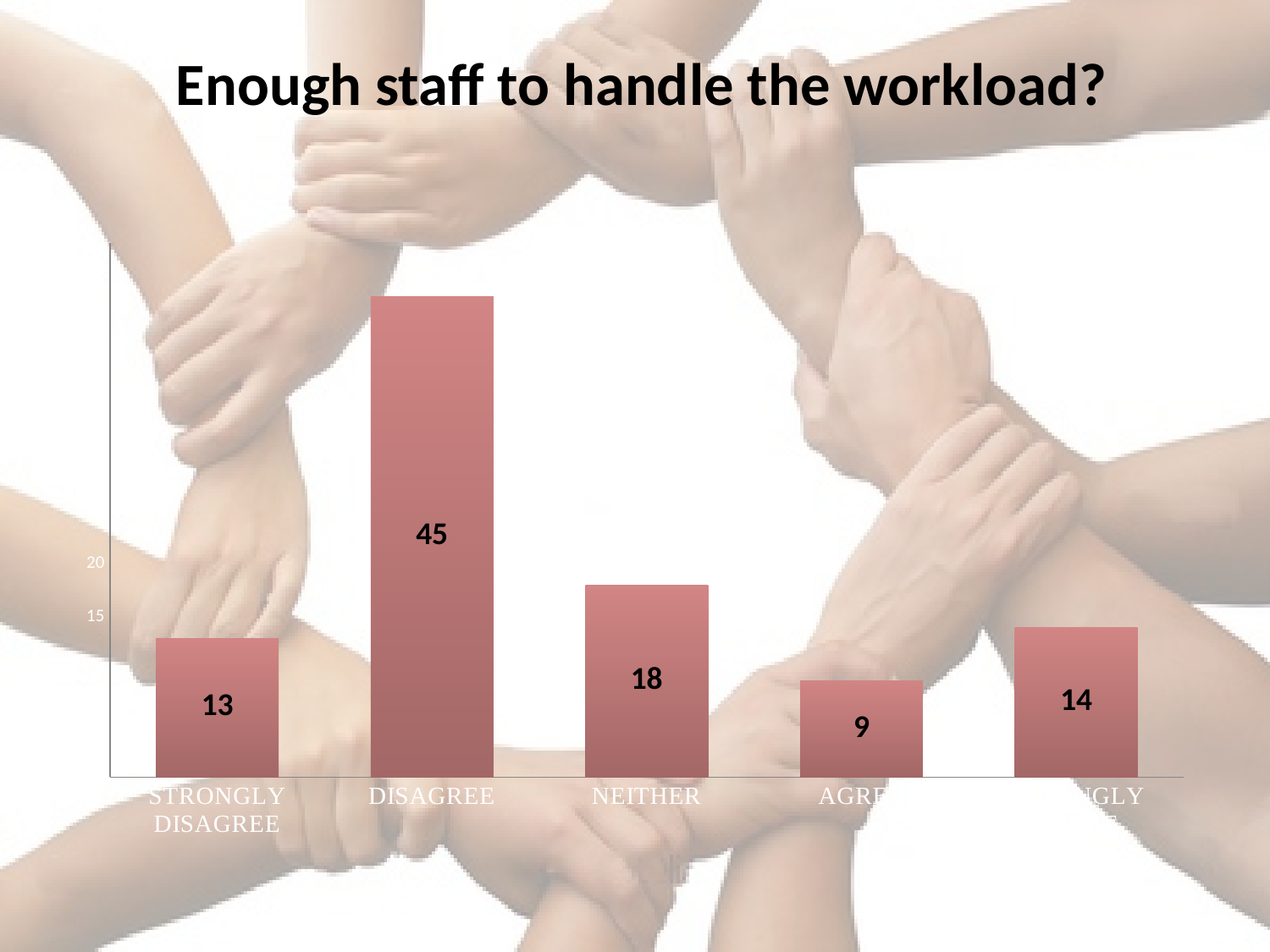
What is the value for Strongly Disagree? 13 What is the value for Neither? 18 What is the difference between the values for Strongly Disagree and Agree? 4 How many categories are shown on the x axis? 5 What is the value for Agree? 9 Is the value for Neither greater or less than 15? greater What kind of chart is shown on the slide? Bar chart What is the difference between the values for Disagree and Neither? 27 Which is larger, the value for Neither or the value for Strongly Disagree? Neither Which category has the highest value? Disagree Which category has the lowest value? Agree What is the value for Disagree? 45